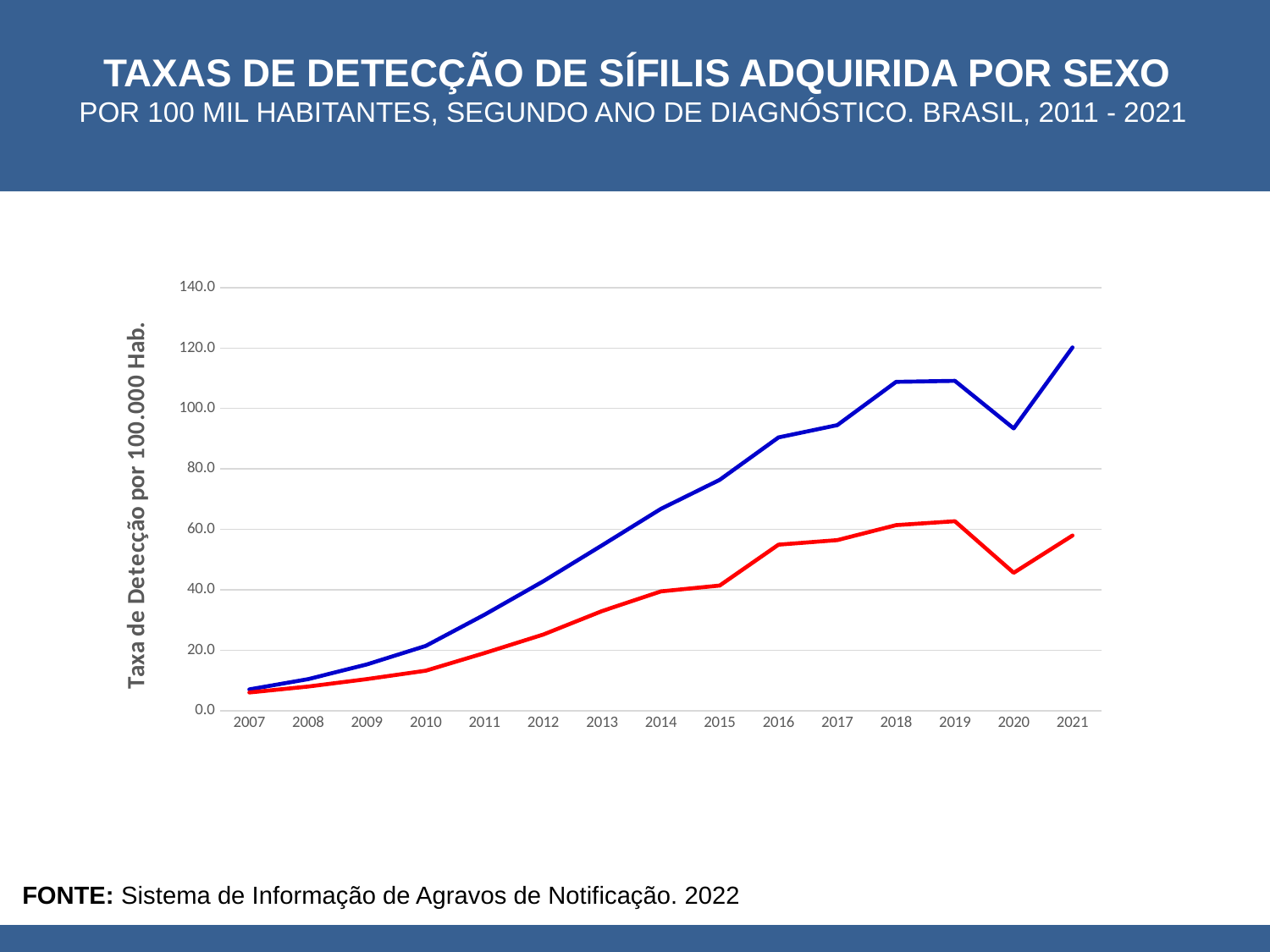
Is the value of the red line in 2016 greater or less than 40? greater How many years are shown on the x axis of the chart? 15 What kind of chart is shown on the slide? line chart What is the title of the vertical axis of the chart? Taxa de Detecção por 100.000 Hab. Is the value of the blue line in 2020 greater or less than 100? less In which year does the blue line reach its highest value? 2021 Is the value of the blue line in 2021 greater or less than 100? greater Do the values of the blue line rise or fall from 2007 to 2019? rise How many lines are plotted on the chart? 2 Which line has the higher value in 2018, the blue line or the red line? the blue line In which year does the blue line have its lowest value? 2007 In which year does the red line have its lowest value? 2007